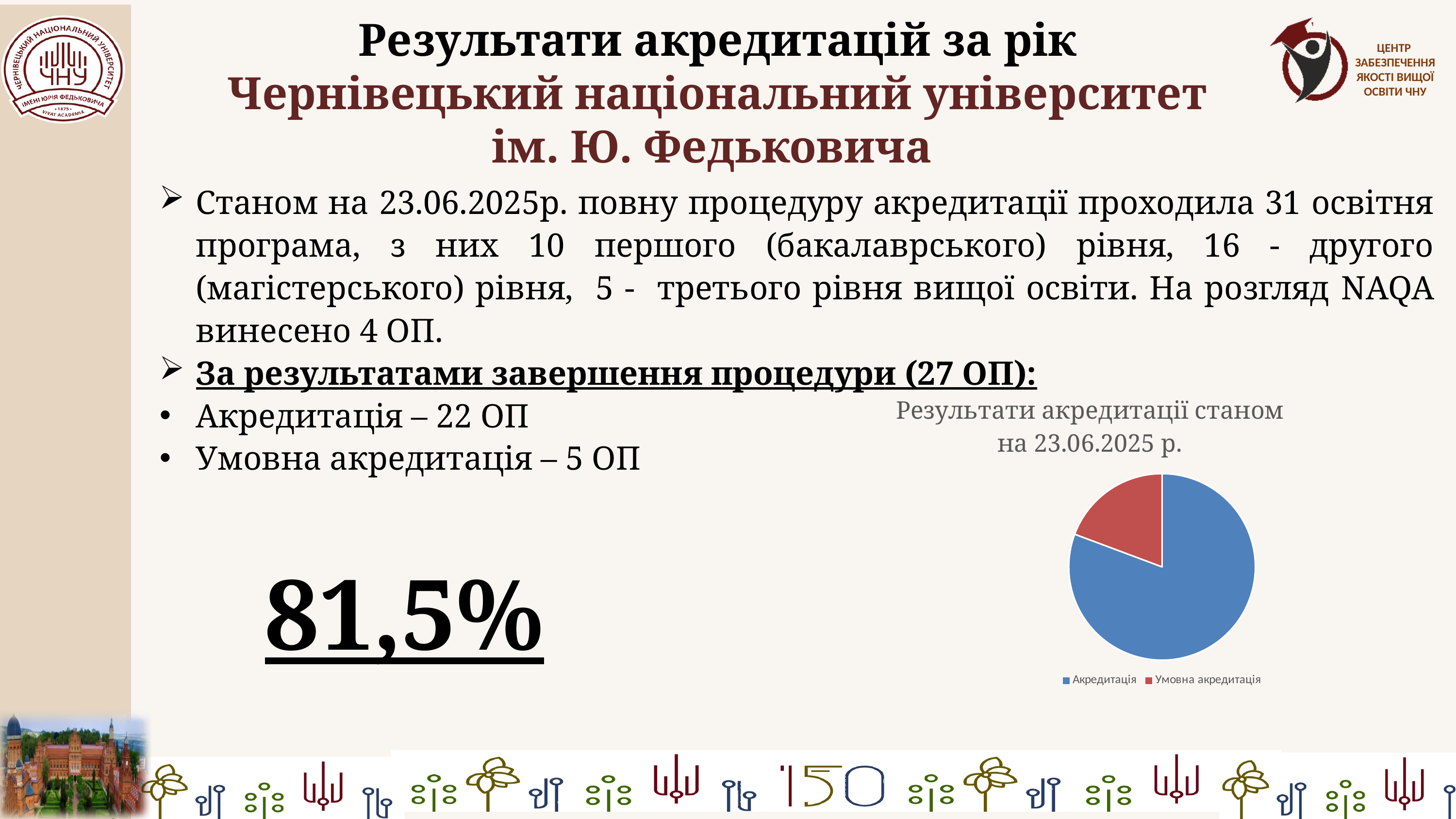
How many slices does the pie chart have? 2 Which slice is larger in the pie chart, Акредитація or Умовна акредитація? Акредитація Which category has the largest slice in the pie chart? Акредитація How many entries does the legend of the pie chart list? 2 What is the title of the pie chart? Результати акредитації станом на 23.06.2025 р. Does the Акредитація slice take up more or less than half of the pie chart? more According to the slide, what share of the completed accreditations does the Акредитація slice represent? 81,5% What kind of chart is shown on the slide? pie chart What colour is the Умовна акредитація slice in the pie chart? red Which category has the smallest slice in the pie chart? Умовна акредитація